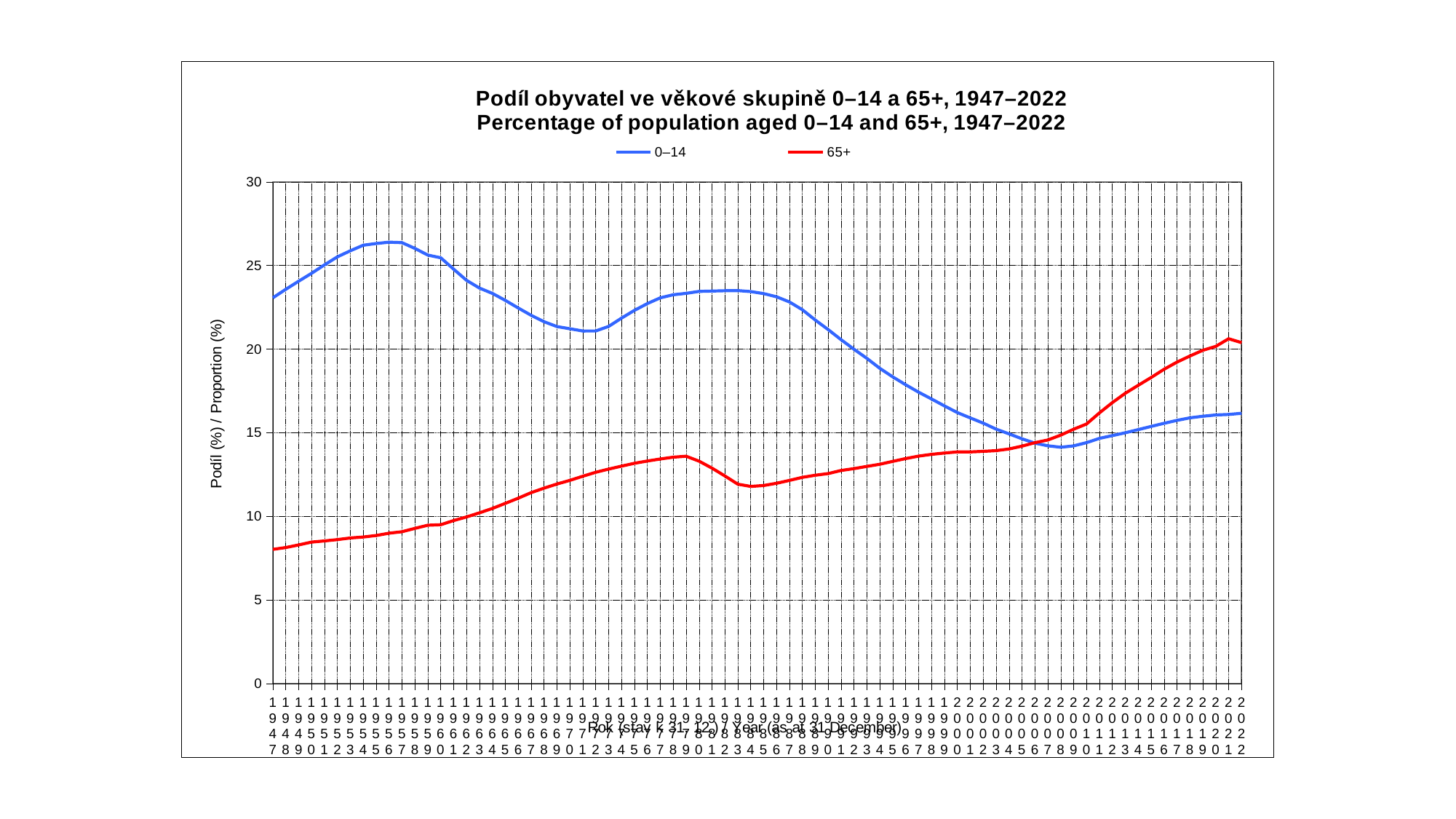
In 1947, which series has the larger value, 0–14 or 65+? 0–14 Is the value for the 65+ series in 1947 greater or less than 10? less Is the value for the 0–14 series in 1947 greater or less than 20? greater Which colour is used for the 65+ series? red In 2022, which series has the larger value, 0–14 or 65+? 65+ What are the two series named in the legend? 0–14 and 65+ How many series does the legend list? 2 Does the 65+ series generally rise or fall from 1947 to 2022? rise How many years are plotted along the x axis? 76 What kind of chart is shown on the slide? line chart Is the value for the 65+ series in 2022 greater or less than 20? greater